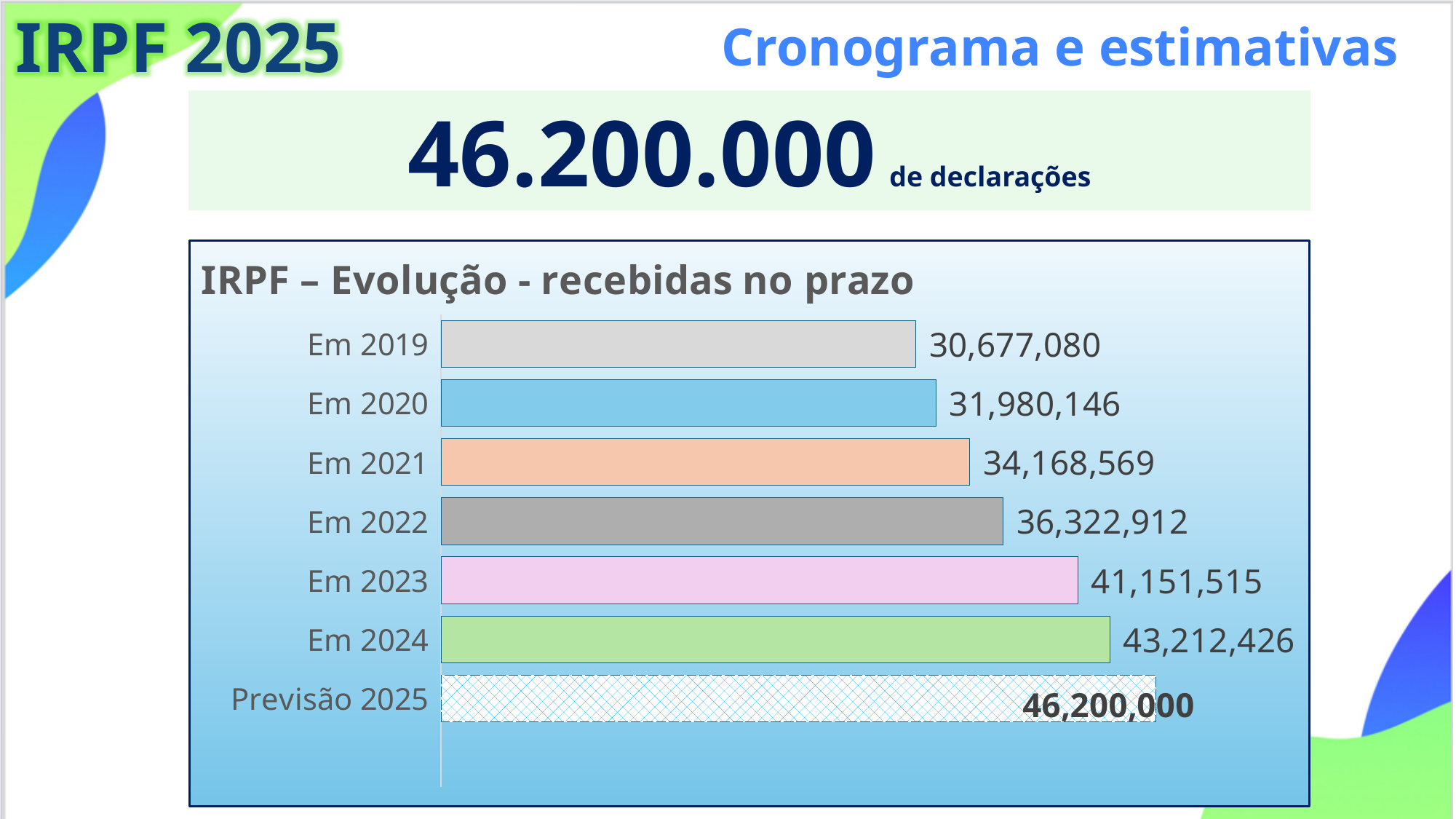
Which category has the highest value? Previsão 2025 What is the difference between the values for Em 2024 and Em 2023? 2,060,911 Which category has the lowest value? Em 2019 What is the value for Previsão 2025? 46,200,000 Which is larger, the value for Em 2021 or the value for Em 2020? Em 2021 What is the difference between the values for Previsão 2025 and Em 2024? 2,987,574 Do the values rise or fall from Em 2019 to Previsão 2025? Rise How many categories are shown in the chart? 7 What kind of chart is shown? Bar chart What is the value for Em 2019? 30,677,080 What is the title of the chart? IRPF – Evolução - recebidas no prazo What is the value for Em 2022? 36,322,912